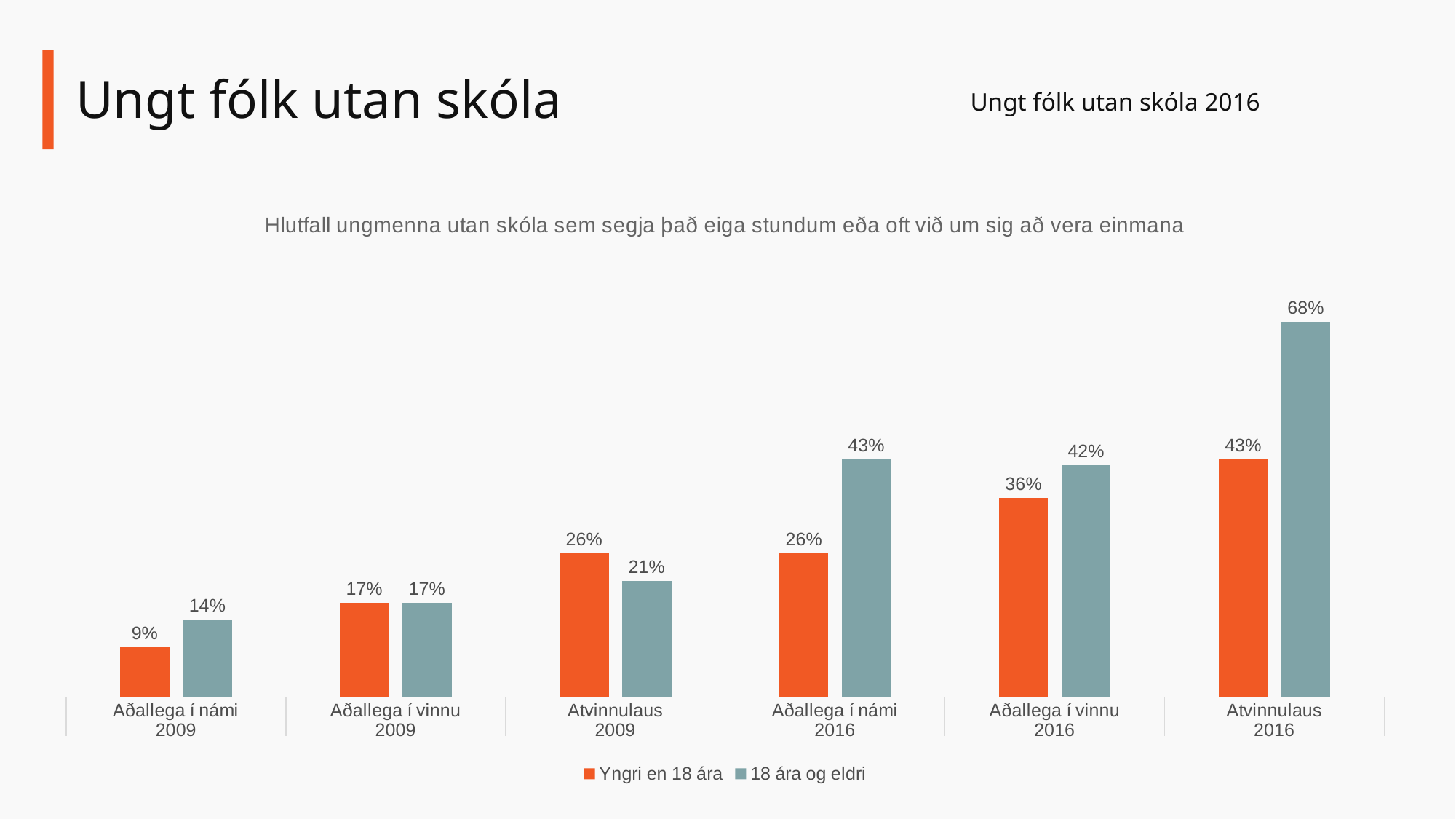
Which category has the lowest value for "Yngri en 18 ára"? Aðallega í námi 2009 What kind of chart is shown on the slide? Bar chart In the "Atvinnulaus 2009" category, which series has the larger value, "Yngri en 18 ára" or "18 ára og eldri"? Yngri en 18 ára What is the difference between the "Yngri en 18 ára" values for "Atvinnulaus 2016" and "Atvinnulaus 2009"? 17% How many series does the legend list? 2 Which colour represents the "Yngri en 18 ára" series? Orange What is the difference between the "18 ára og eldri" and "Yngri en 18 ára" values in the "Atvinnulaus 2016" category? 25% What is the value for "Yngri en 18 ára" in the "Atvinnulaus 2016" category? 43% What is the value for "18 ára og eldri" in the "Aðallega í námi 2009" category? 14% Which category has the highest value for "18 ára og eldri"? Atvinnulaus 2016 What is the value for "Yngri en 18 ára" in the "Aðallega í vinnu 2016" category? 36% How many categories are shown on the x axis? 6